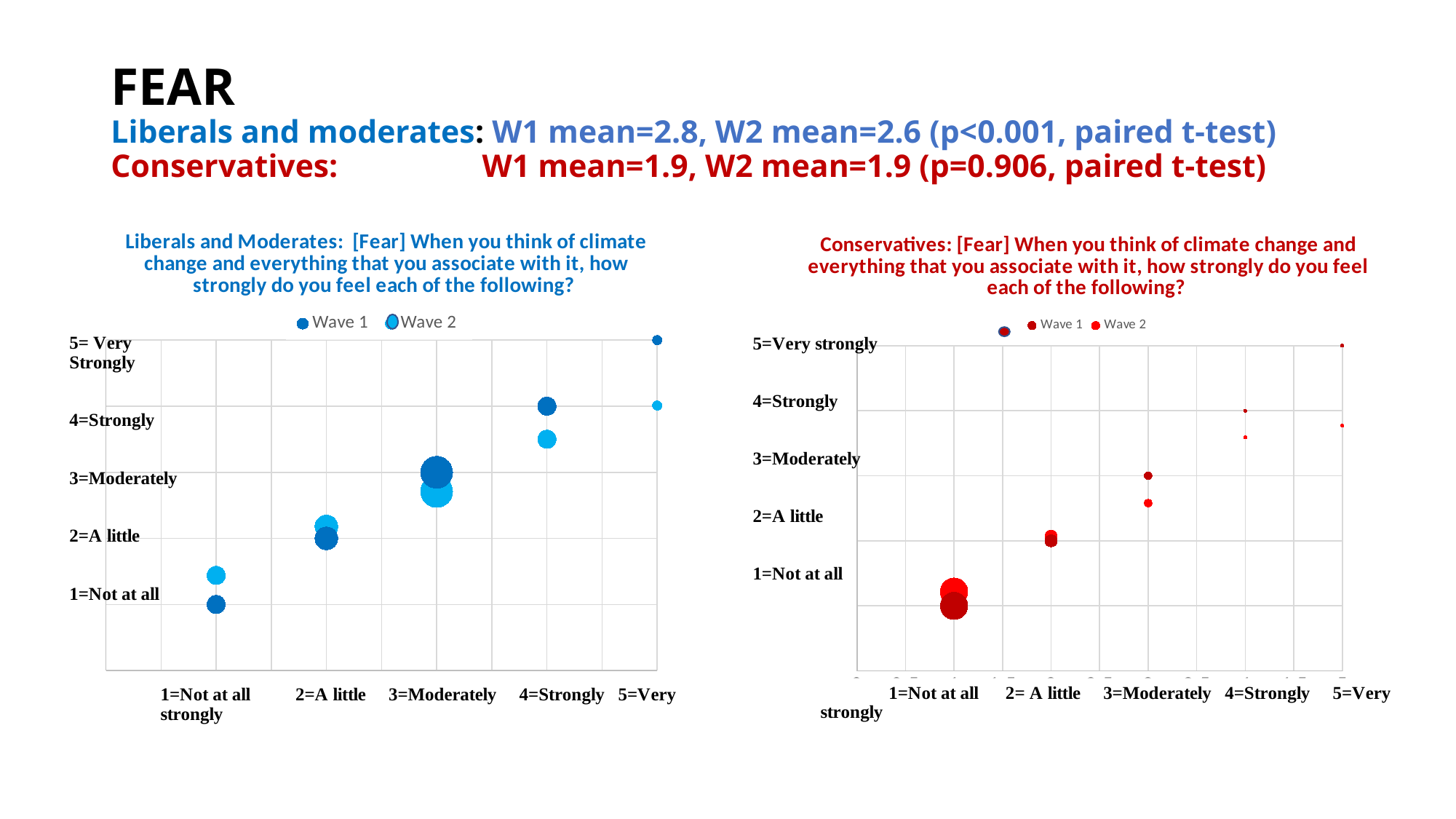
How many categories are shown on the y axis of the Conservatives chart? 5 How many series does the legend list in the Liberals and Moderates chart? 2 In the Liberals and Moderates chart, which bubble is larger: the one at 3=Moderately or the one at 5=Very strongly? 3=Moderately In the Liberals and Moderates chart, at which x-axis category is the largest bubble located? 3=Moderately How many series does the legend list in the Conservatives chart? 2 In the Conservatives chart, at which x-axis category is the largest bubble located? 1=Not at all In the Conservatives chart, which bubble is larger: the one at 1=Not at all or the one at 5=Very strongly? 1=Not at all What are the legend entries in the Conservatives chart? Wave 1 and Wave 2 In the Liberals and Moderates chart, do the bubbles rise or fall along the y axis as you move from left to right along the x axis? rise What colour are the bubbles in the Liberals and Moderates chart? blue How many categories are shown on the x axis of the Liberals and Moderates chart? 5 What kind of chart is the "Liberals and Moderates" chart on the left? bubble chart